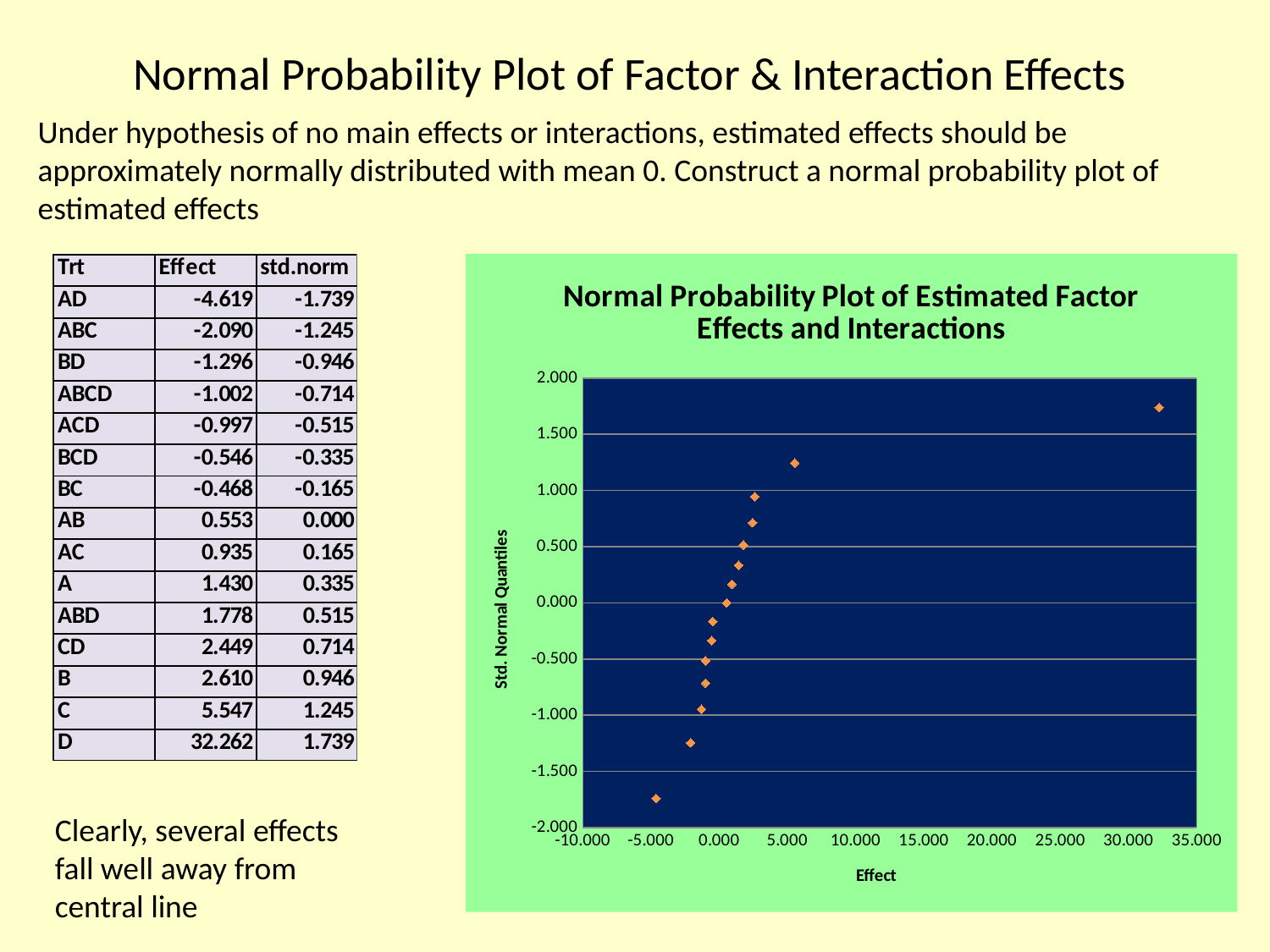
What is the title of the chart? Normal Probability Plot of Estimated Factor Effects and Interactions According to the table on the slide, which treatment has the highest estimated Effect? D Is the Std. Normal Quantile of the highest point in the chart greater or less than 1.500? greater Is the Std. Normal Quantile of the lowest point in the chart greater or less than -1.500? less What is the largest value shown on the x axis of the chart? 35.000 How many data points are plotted in the chart? 15 What is the label of the vertical axis of the chart? Std. Normal Quantiles According to the table on the slide, which treatment has the lowest estimated Effect? AD What kind of chart is shown on the slide? scatter plot Is the Effect value of the rightmost point in the chart greater or less than 30.000? greater Do the plotted points rise or fall as the Effect value increases along the x axis? rise